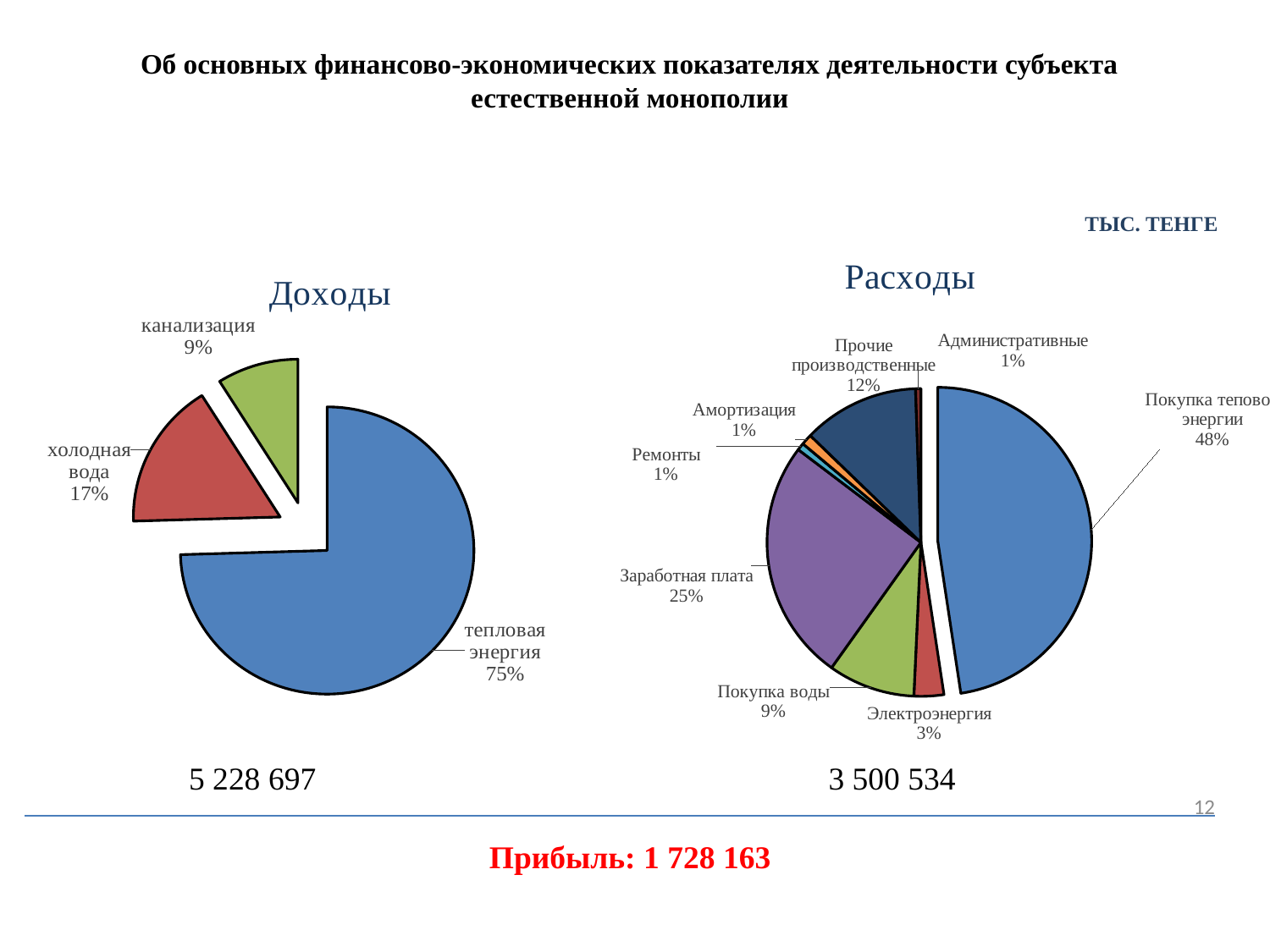
In the "Расходы" chart, what share does "Покупка воды" have? 9% What type of chart is the "Расходы" chart? pie chart In the "Расходы" chart, what is the difference between the shares of "Покупка тепово энергии" and "Заработная плата"? 23% In the "Доходы" chart, what is the difference between the shares of "холодная вода" and "канализация"? 8% How many slices does the "Доходы" pie chart have? 3 In the "Расходы" chart, which slice is the largest? Покупка тепово энергии In the "Доходы" chart, what share does "тепловая энергия" have? 75% In the "Расходы" chart, which is larger: "Прочие производственные" or "Электроэнергия"? Прочие производственные In the "Доходы" chart, which slice is the smallest? канализация In the "Доходы" chart, what share does "холодная вода" have? 17% How many slices does the "Расходы" pie chart have? 8